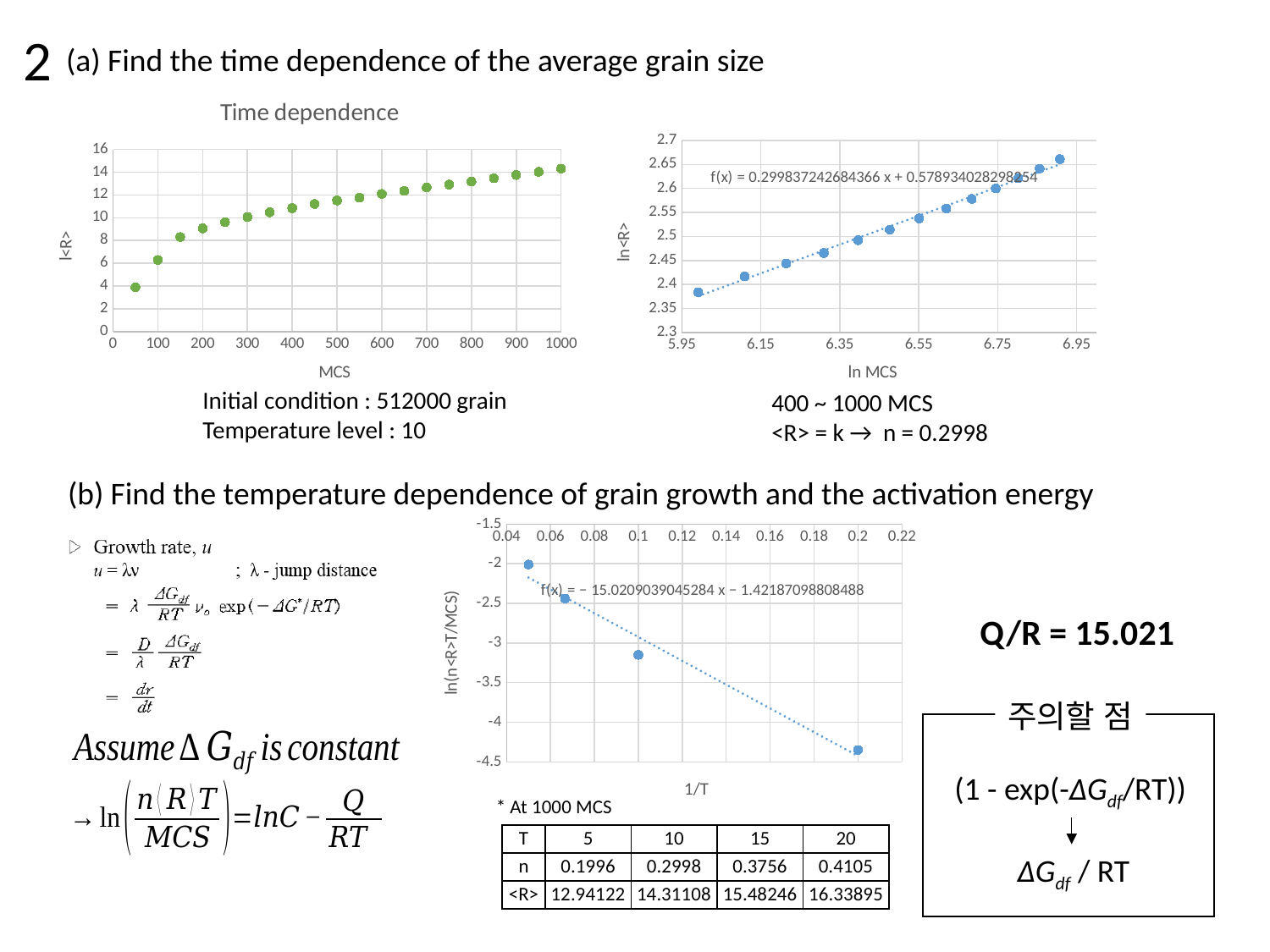
In the 'Time dependence' chart, is the value at 500 MCS greater or less than 10? greater In the top-right chart (ln<R> vs ln MCS), do the values rise or fall as ln MCS increases? rise In the 'Time dependence' chart, do the values rise or fall as MCS increases? rise In the bottom chart (ln(n<R>T/MCS) vs 1/T), is the value at 1/T = 0.2 greater or less than -4? less In the top-right chart (ln<R> vs ln MCS), what is the slope of the fitted line shown in the equation? 0.299837242684366 In the bottom chart (ln(n<R>T/MCS) vs 1/T), what is the slope of the fitted line shown in the equation? -15.0209039045284 What kind of chart is the 'Time dependence' chart? scatter chart In the 'Time dependence' chart, which MCS value has the lowest l<R>? 50 What is the title of the top-left chart? Time dependence In the bottom chart (ln(n<R>T/MCS) vs 1/T), how many data points are plotted? 4 In the 'Time dependence' chart, is the value at 100 MCS greater or less than 8? less What is the x-axis label of the top-right chart (ln<R> vs ln MCS)? ln MCS